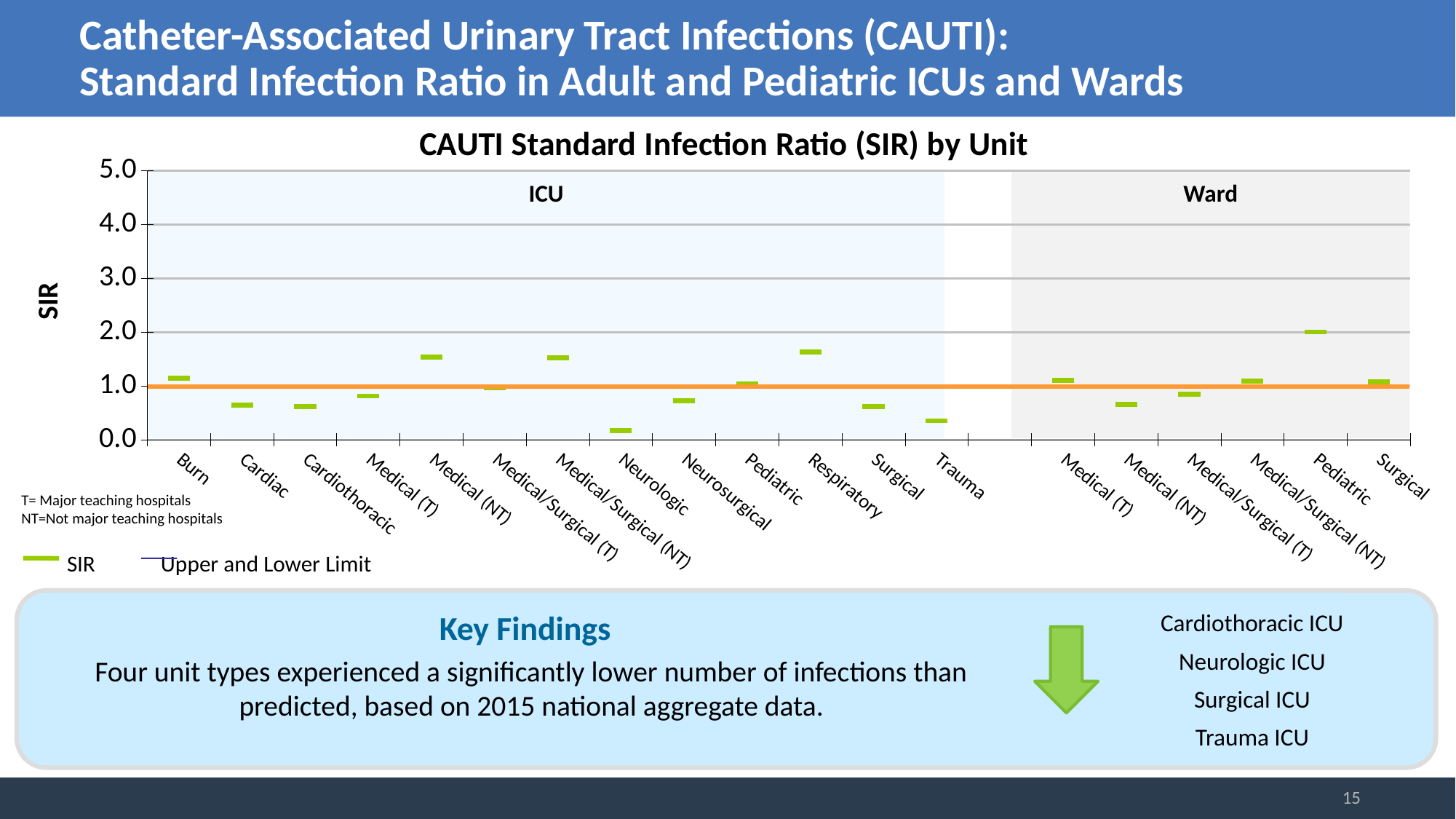
Is the SIR for the Medical (NT) ICU greater or less than 1.0? greater What is the maximum value shown on the SIR axis of the chart? 5.0 Which unit has the highest SIR in the chart? Pediatric (Ward) Which unit has the lowest SIR in the chart? Neurologic (ICU) What is the title of the chart? CAUTI Standard Infection Ratio (SIR) by Unit How many unit categories are in the Ward section of the chart? 6 How many entries does the chart legend list? 2 Is the SIR for the Trauma ICU greater or less than 1.0? less Is the SIR for the Respiratory ICU greater or less than 1.0? greater How many unit categories are plotted along the x axis of the chart? 19 How many unit categories are in the ICU section of the chart? 13 Which has the larger SIR: the Respiratory ICU or the Trauma ICU? Respiratory ICU